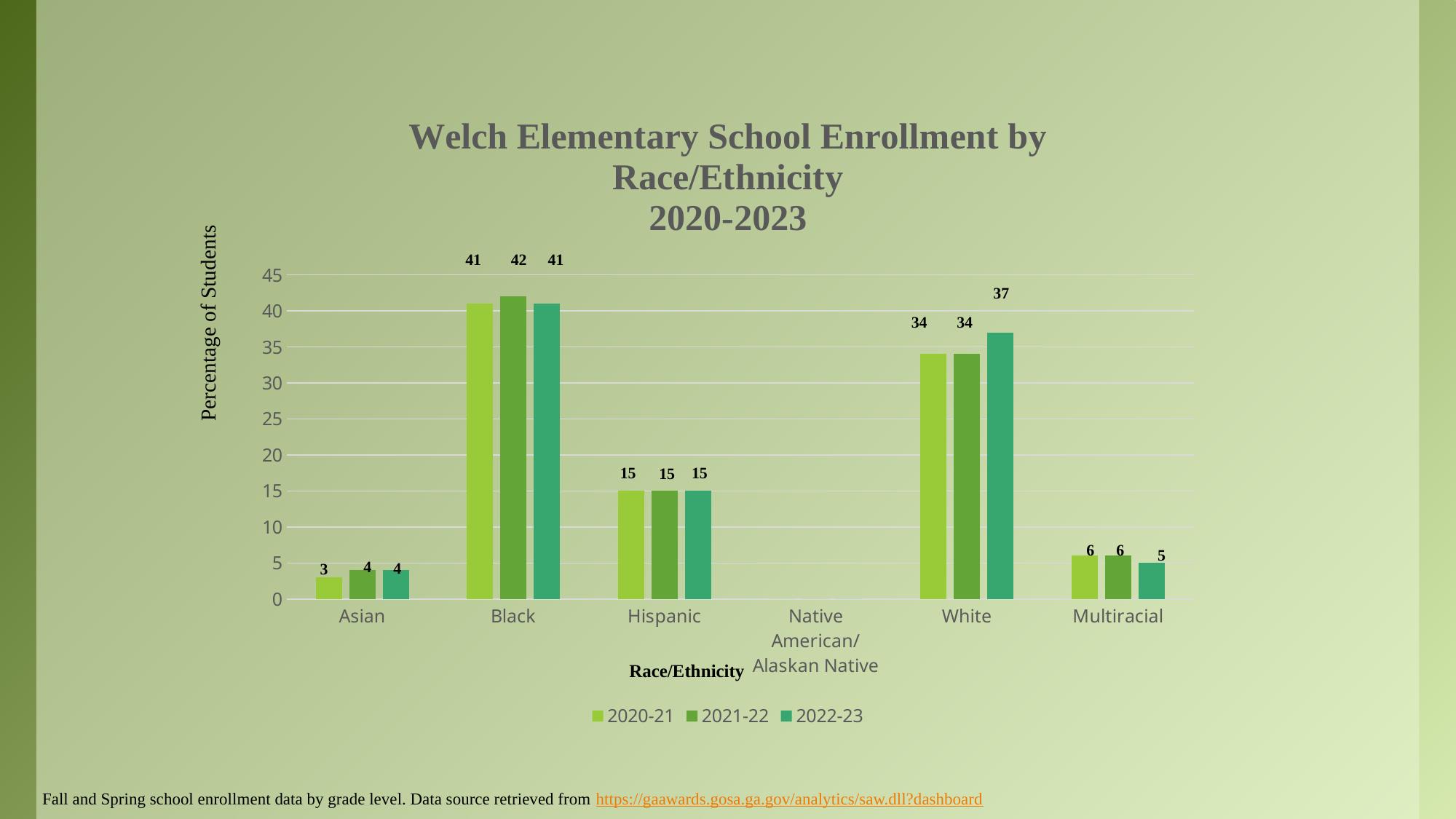
What is the difference between the White value in 2022-23 and the White value in 2020-21? 3 What is the value for Black in the 2021-22 series? 42 What is the value for White in the 2022-23 series? 37 What is the value for Asian in the 2020-21 series? 3 What is the label of the y axis? Percentage of Students How many series does the legend list? 3 What is the title of the chart? Welch Elementary School Enrollment by Race/Ethnicity 2020-2023 Which is larger: the Hispanic value in 2021-22 or the Multiracial value in 2021-22? Hispanic How many race/ethnicity categories are shown on the x axis? 6 Which race/ethnicity category has the highest value in the 2020-21 series? Black Which race/ethnicity category with a plotted bar has the lowest value in the 2022-23 series? Asian What kind of chart is shown on the slide? Bar chart